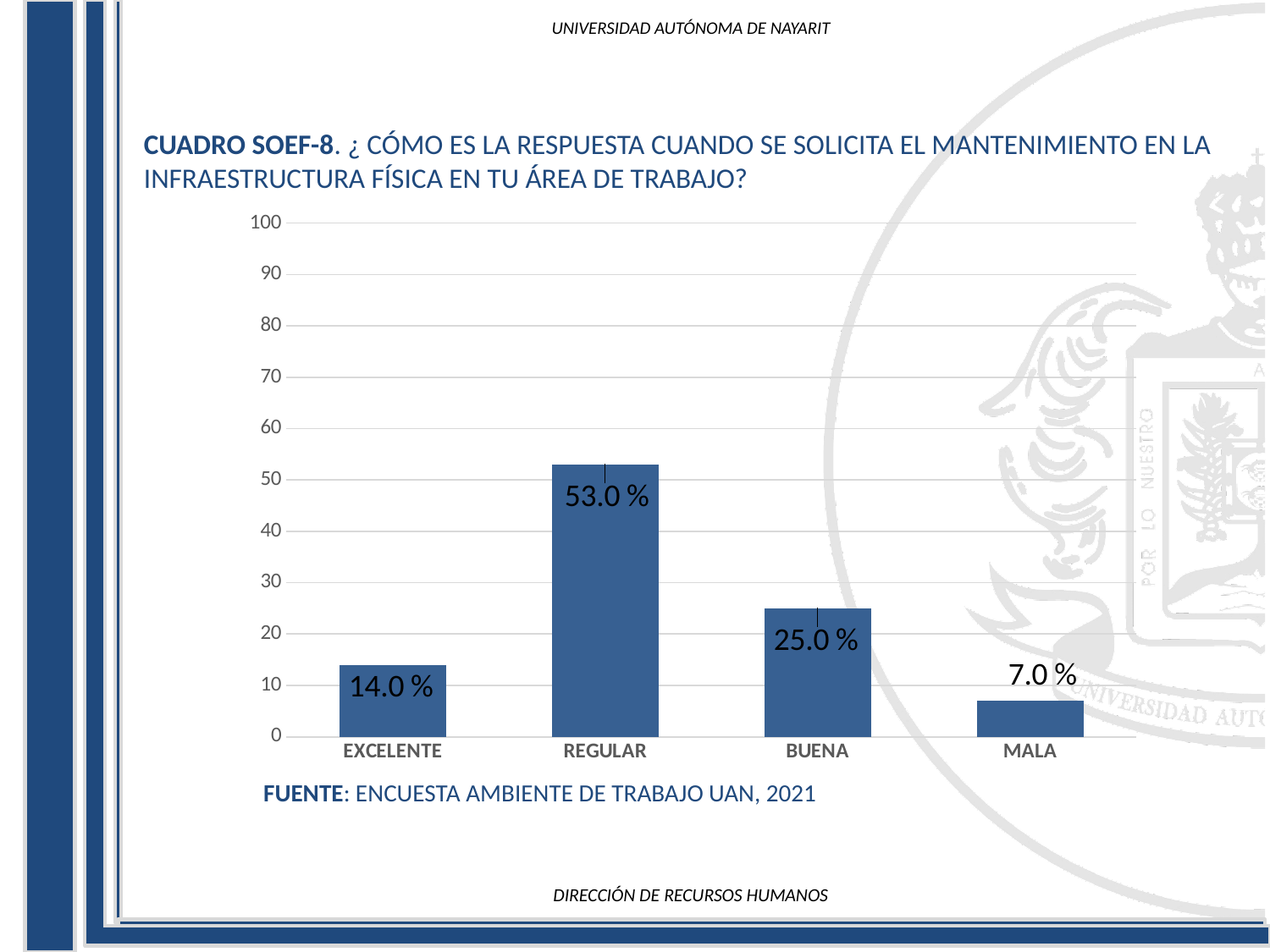
Which is larger, the value for BUENA or the value for EXCELENTE? BUENA What is the value for REGULAR? 53.0 % What is the difference between the values for REGULAR and BUENA? 28.0 % How many categories are shown on the x axis? 4 What kind of chart is shown on the slide? bar chart What is the difference between the values for EXCELENTE and MALA? 7.0 % What is the value for BUENA? 25.0 % Is the value for REGULAR greater or less than 50? greater Which category has the lowest value? MALA Which category has the highest value? REGULAR What is the value for EXCELENTE? 14.0 % What is the value for MALA? 7.0 %